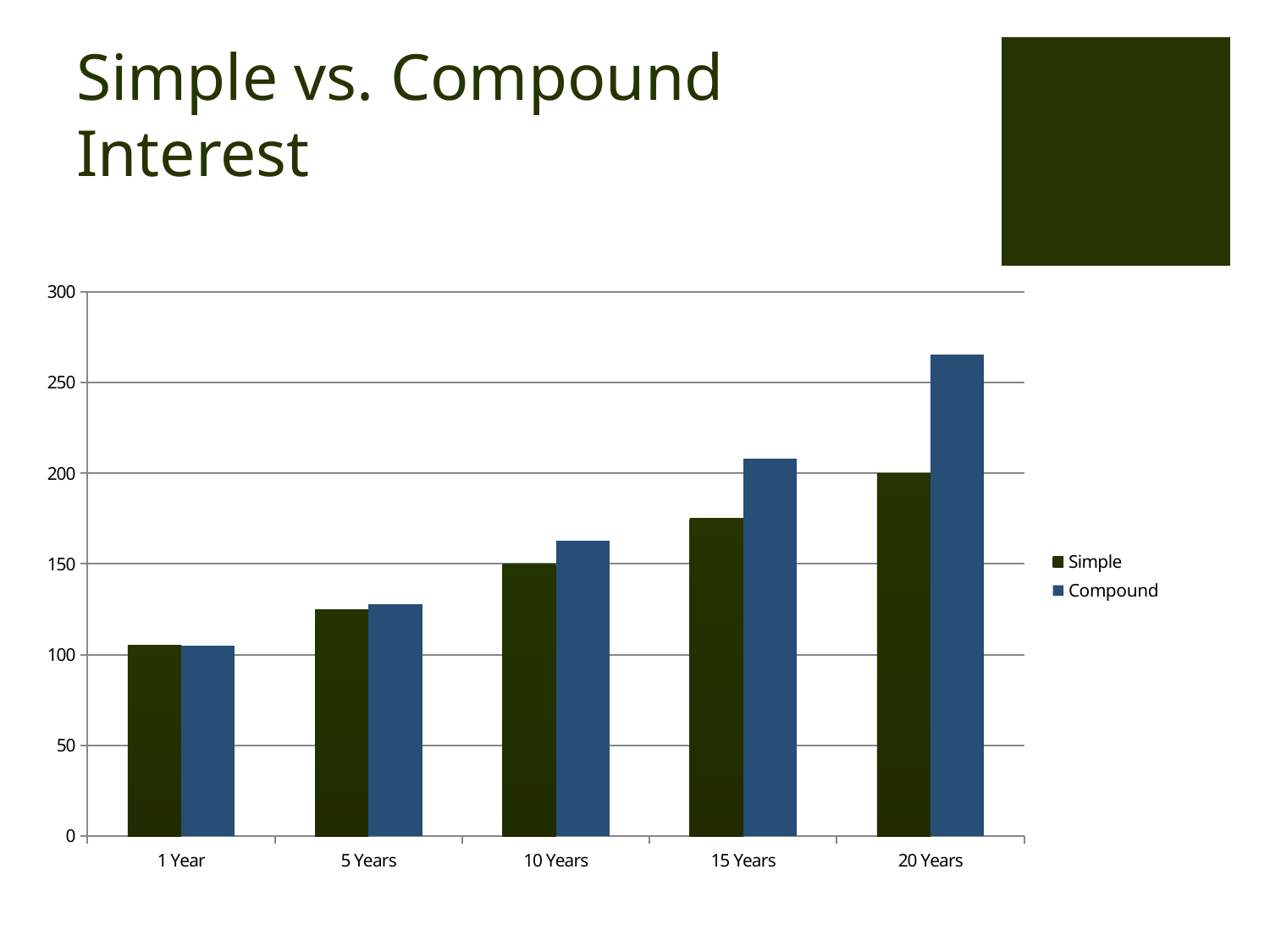
At 20 Years, which series has the larger value, Simple or Compound? Compound Is the value for Compound at 20 Years greater or less than 250? greater Is the value for Compound at 15 Years greater or less than 200? greater What is the value of the Simple series at 20 Years? 200 Which category has the highest Compound value? 20 Years What are the two entries listed in the legend? Simple and Compound How many series does the legend list? 2 How many time-period categories are shown on the x axis? 5 What kind of chart is shown on the slide? bar chart Is the value for Simple at 5 Years greater or less than 150? less Do the Compound values rise or fall as the time period increases along the x axis? rise What is the value of the Simple series at 10 Years? 150